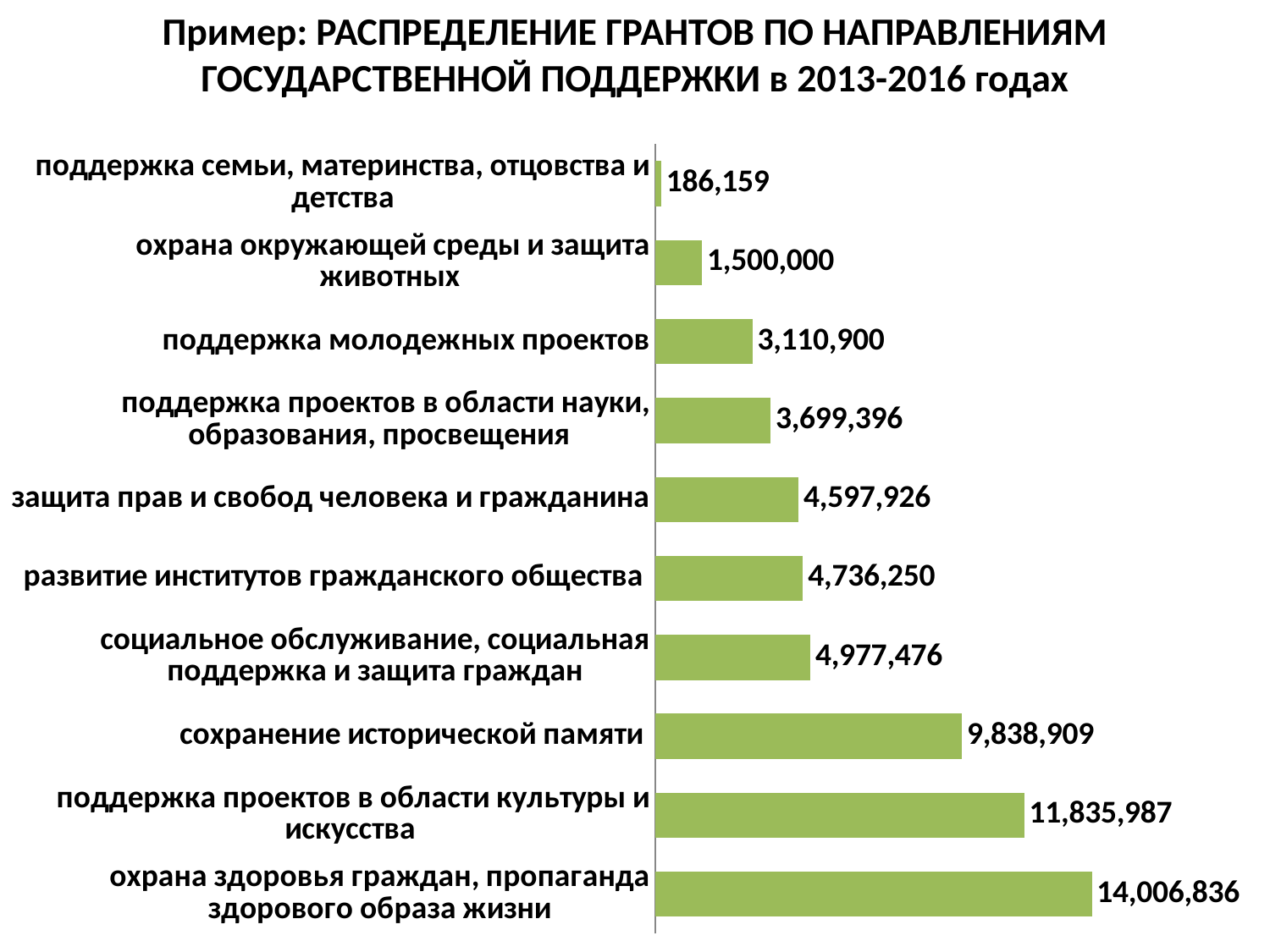
Какое значение указано для направления «поддержка молодежных проектов»? 3,110,900 На сколько значение для направления «поддержка проектов в области науки, образования, просвещения» больше значения для направления «поддержка молодежных проектов»? 588,496 Какое значение указано для направления «охрана окружающей среды и защита животных»? 1,500,000 Какое значение указано для направления «сохранение исторической памяти»? 9,838,909 Какое направление имеет наибольшее значение на диаграмме? охрана здоровья граждан, пропаганда здорового образа жизни На сколько значение для направления «охрана здоровья граждан, пропаганда здорового образа жизни» больше значения для направления «поддержка проектов в области культуры и искусства»? 2,170,849 Какое значение указано для направления «защита прав и свобод человека и гражданина»? 4,597,926 Какого цвета столбцы на диаграмме? зелёного Какое направление имеет наименьшее значение на диаграмме? поддержка семьи, материнства, отцовства и детства Какое направление имеет большее значение: «сохранение исторической памяти» или «социальное обслуживание, социальная поддержка и защита граждан»? сохранение исторической памяти Какой тип диаграммы показан на слайде? столбчатая диаграмма (bar chart) Сколько направлений (категорий) показано на диаграмме? 10